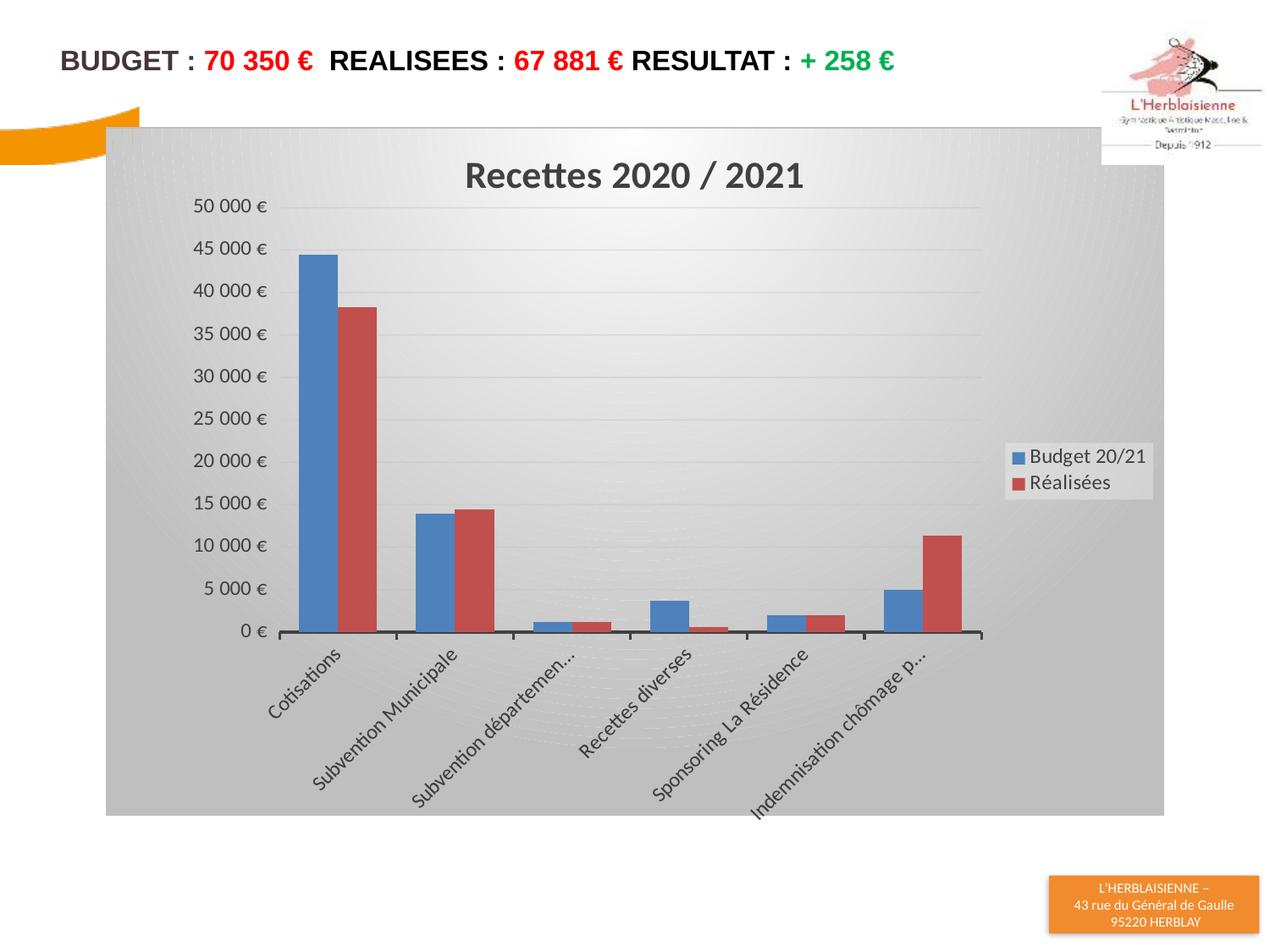
For Cotisations, which is larger: the Budget 20/21 value or the Réalisées value? Budget 20/21 For the category starting with 'Indemnisation chômage', which is larger: the Budget 20/21 value or the Réalisées value? Réalisées Which category has the highest Réalisées value? Cotisations Which category has the highest Budget 20/21 value? Cotisations How many categories are shown on the x axis of the chart? 6 For Recettes diverses, which is larger: the Budget 20/21 value or the Réalisées value? Budget 20/21 Is the Réalisées value for the category starting with 'Indemnisation chômage' greater or less than 10 000 €? greater How many series does the chart legend list? 2 What is the title of the chart? Recettes 2020 / 2021 Is the Budget 20/21 value for Cotisations greater or less than 40 000 €? greater Is the Réalisées value for Cotisations greater or less than 40 000 €? less What kind of chart is shown on the slide? Bar chart